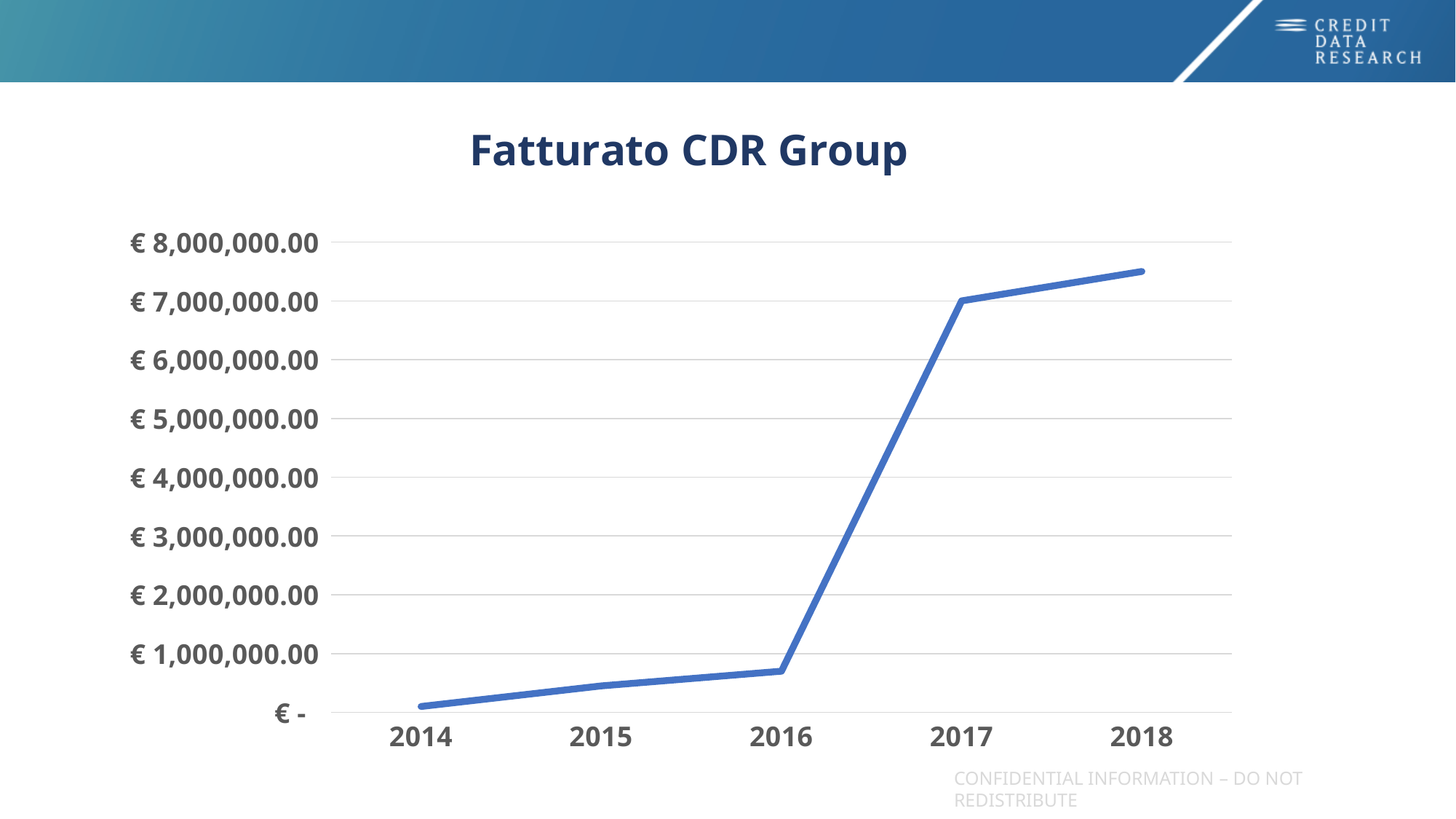
Is the value for 2018 greater or less than € 7,000,000.00? greater Is the value for 2017 greater or less than € 6,000,000.00? greater Is the value for 2016 greater or less than € 1,000,000.00? less Which year has the larger value, 2016 or 2017? 2017 Which year has the highest value? 2018 How many years are plotted on the x axis? 5 Which year has the lowest value? 2014 What is the title of the chart? Fatturato CDR Group What kind of chart is shown on the slide? line chart Do the values rise or fall from 2014 to 2018? rise Which year has the larger value, 2014 or 2015? 2015